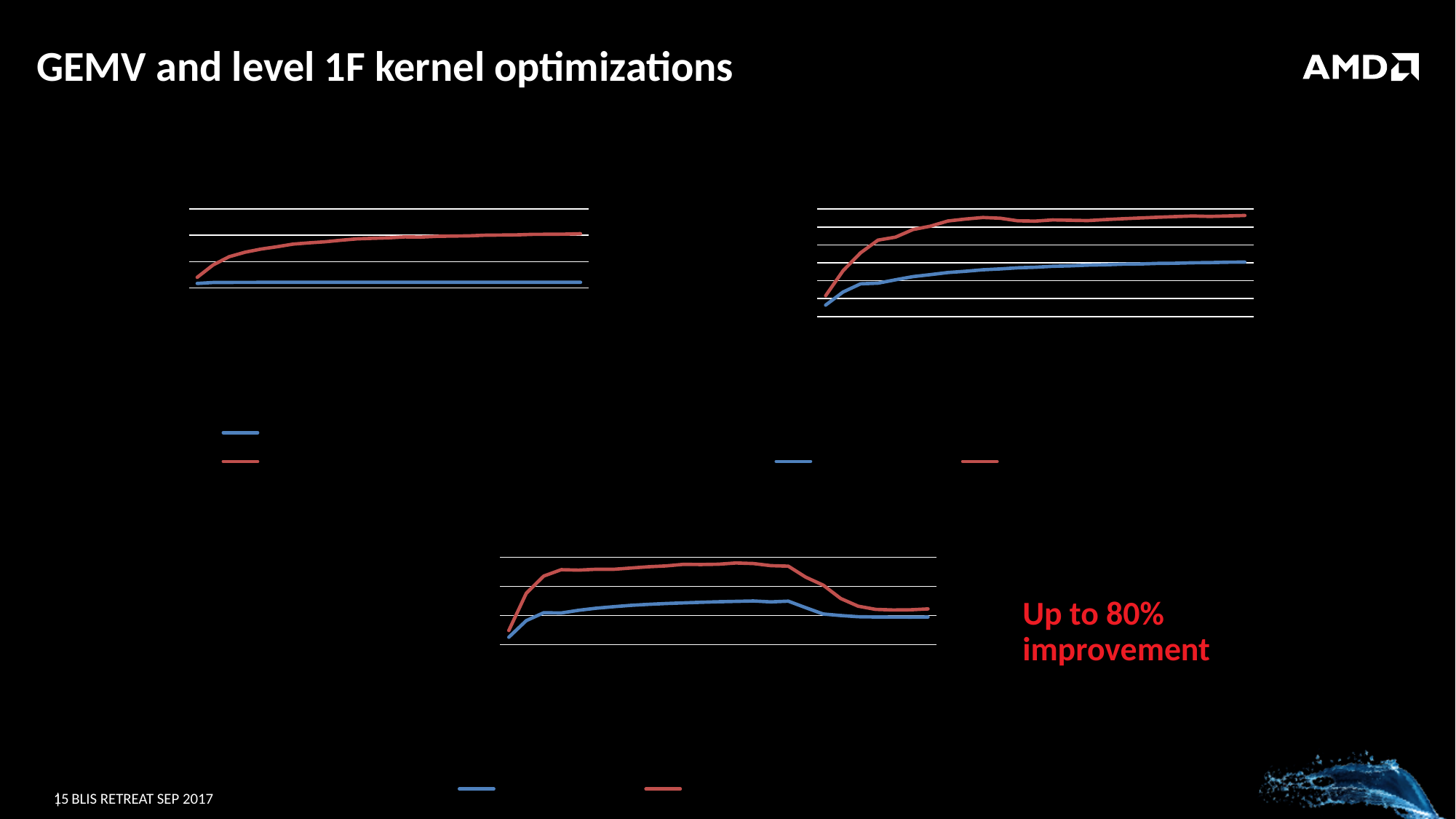
What kind of chart is the top-right chart? line chart What kind of chart is the top-left chart? line chart How many charts are shown on the slide? 3 What kind of chart is the bottom chart? line chart In the bottom chart, does the red line rise or fall over the right-hand portion of the x axis? fall In the top-right chart, does the blue line rise or fall from left to right? rise How many series does the legend of the top-left chart list? 2 In the top-right chart, which line is higher at the right end, the red line or the blue line? the red line In the bottom chart, which line is higher in the middle of the x axis, the red line or the blue line? the red line In the top-left chart, which line is higher at the right end, the red line or the blue line? the red line How many series does the legend of the bottom chart list? 2 What two colours are used for the lines in the charts? red and blue